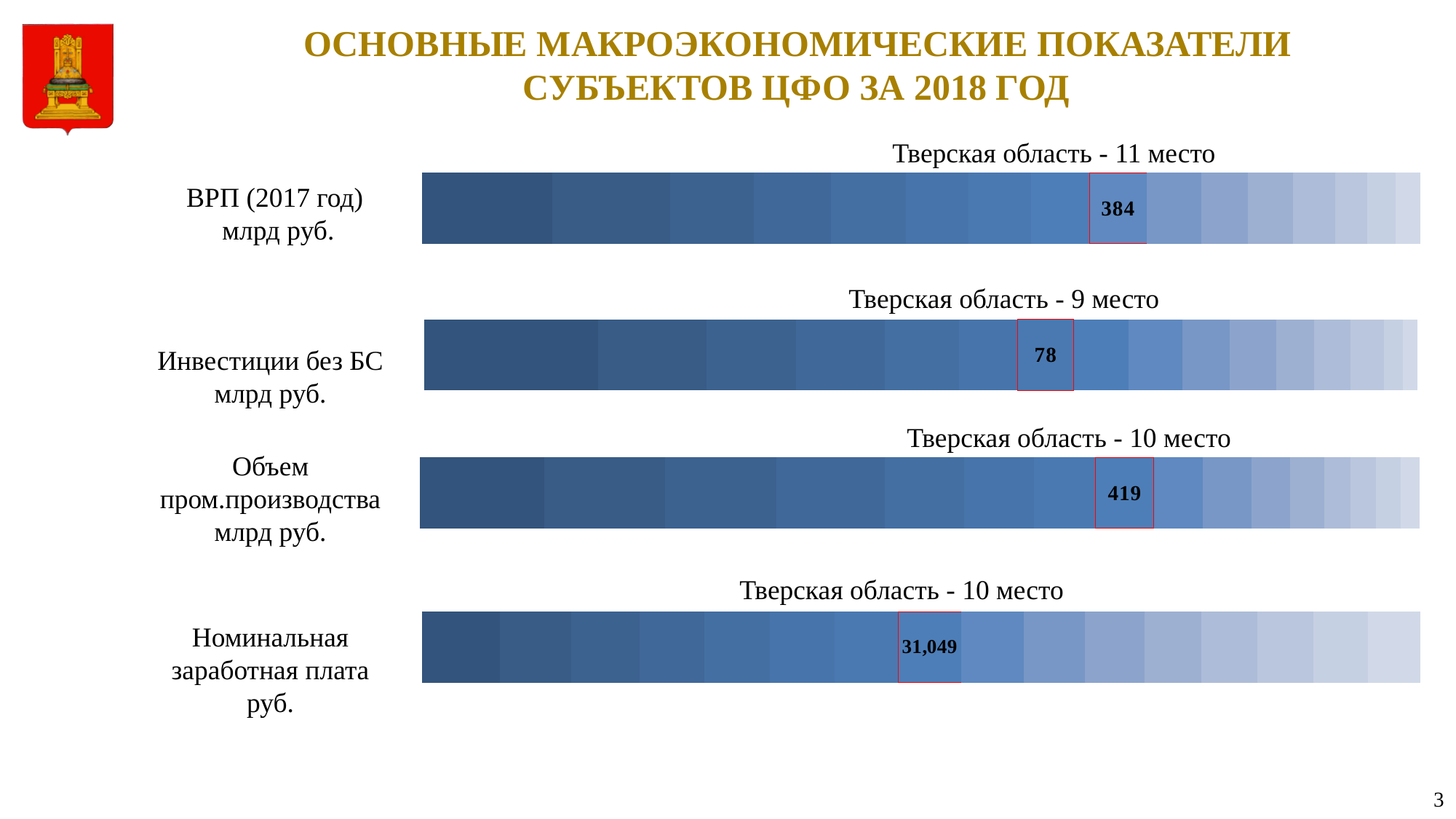
What place does Тверская область hold for Объем пром.производства according to the label above the bar? 10 место What is the title of the slide? ОСНОВНЫЕ МАКРОЭКОНОМИЧЕСКИЕ ПОКАЗАТЕЛИ СУБЪЕКТОВ ЦФО ЗА 2018 ГОД Which printed value for Тверская область is larger: ВРП (2017 год) or Объем пром.производства? Объем пром.производства What kind of chart is used to show each indicator on the slide? Bar chart What place does Тверская область hold for Инвестиции без БС according to the label above the bar? 9 место What value is printed for Тверская область on the Объем пром.производства bar? 419 What value is printed for Тверская область on the Инвестиции без БС bar? 78 What value is printed for Тверская область on the Номинальная заработная плата bar? 31,049 What place does Тверская область hold for ВРП (2017 год) according to the label above the bar? 11 место What value is printed for Тверская область on the ВРП (2017 год) bar? 384 What is the difference between the printed Тверская область values for Объем пром.производства and ВРП (2017 год)? 35 How many indicator bars are shown on the slide? 4